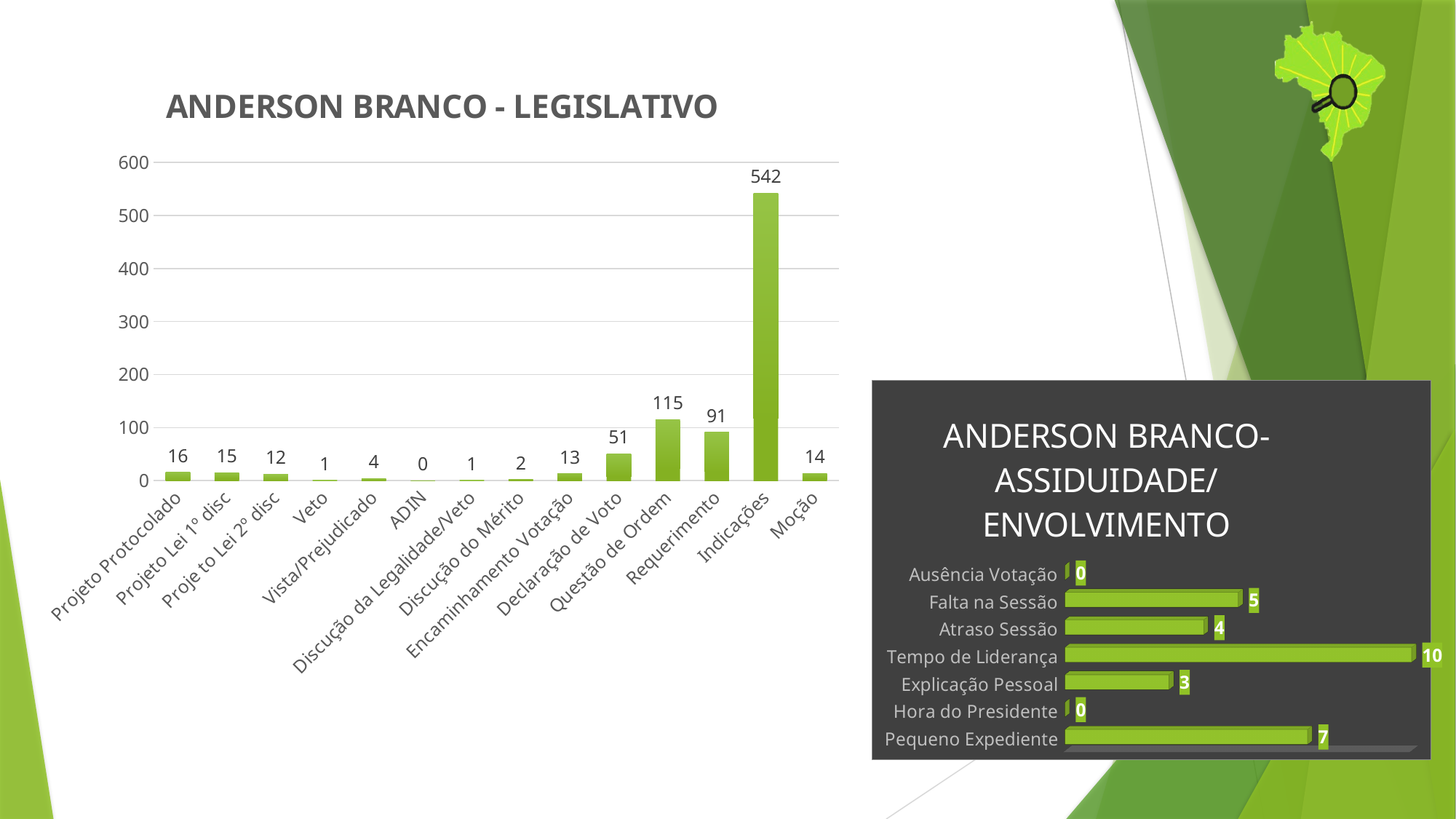
In the 'ANDERSON BRANCO- ASSIDUIDADE/ENVOLVIMENTO' chart, what is the value for Pequeno Expediente? 7 In the 'ANDERSON BRANCO - LEGISLATIVO' chart, which is larger: Projeto Protocolado or Moção? Projeto Protocolado How many categories are shown in the 'ANDERSON BRANCO- ASSIDUIDADE/ENVOLVIMENTO' chart? 7 In the 'ANDERSON BRANCO- ASSIDUIDADE/ENVOLVIMENTO' chart, what is the difference between Falta na Sessão and Explicação Pessoal? 2 In the 'ANDERSON BRANCO - LEGISLATIVO' chart, what is the difference between Questão de Ordem and Requerimento? 24 In the 'ANDERSON BRANCO - LEGISLATIVO' chart, what is the value for Indicações? 542 What kind of chart is 'ANDERSON BRANCO - LEGISLATIVO'? Bar chart How many categories are shown in the 'ANDERSON BRANCO - LEGISLATIVO' chart? 14 In the 'ANDERSON BRANCO - LEGISLATIVO' chart, which category has the lowest value? ADIN In the 'ANDERSON BRANCO - LEGISLATIVO' chart, which category has the highest value? Indicações In the 'ANDERSON BRANCO - LEGISLATIVO' chart, what is the value for Questão de Ordem? 115 In the 'ANDERSON BRANCO- ASSIDUIDADE/ENVOLVIMENTO' chart, what is the value for Tempo de Liderança? 10